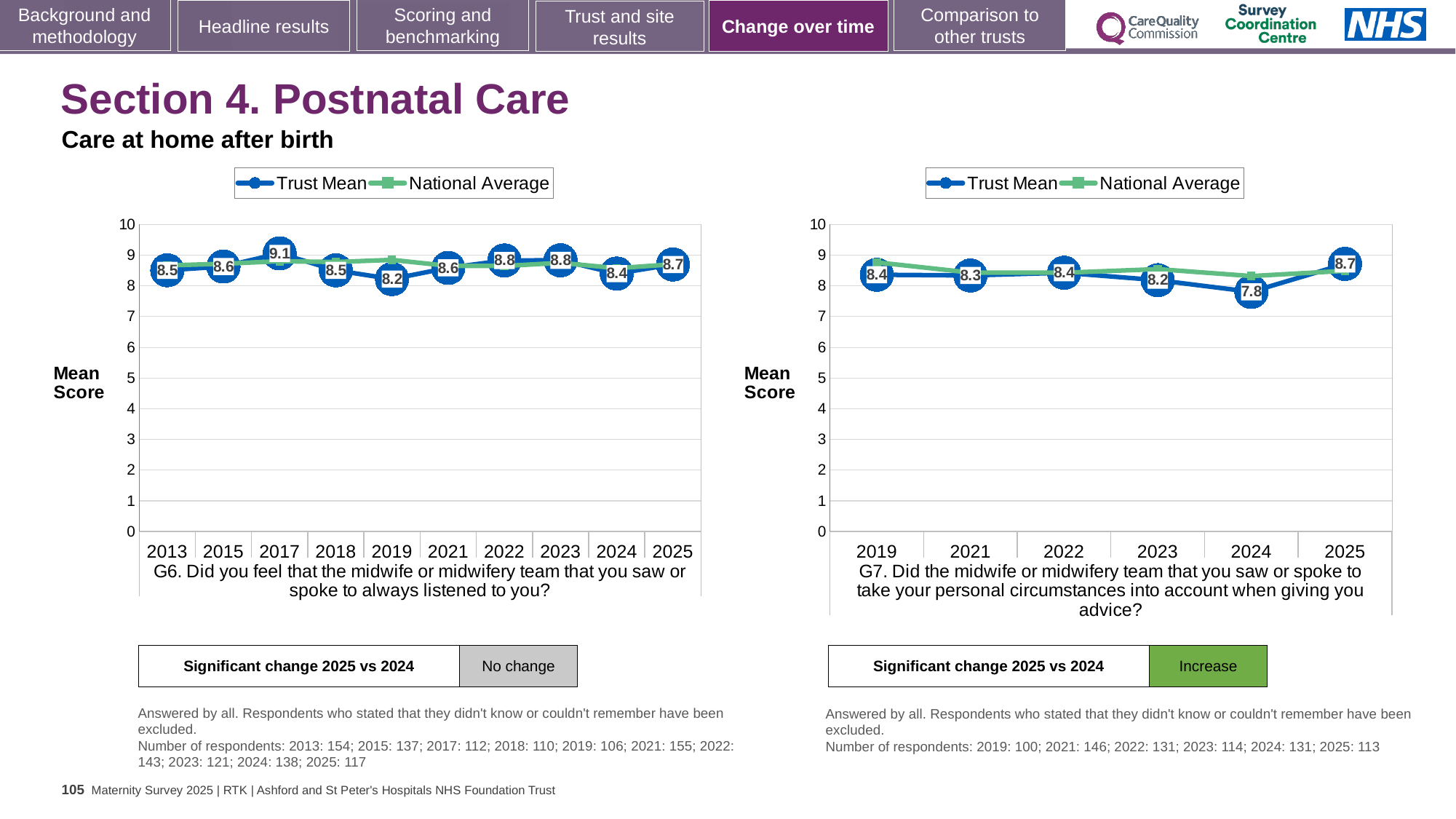
In the right chart (G7), what is the difference between the Trust Mean scores for 2025 and 2024? 0.9 In the right chart (G7), is the Trust Mean score for 2021 larger or smaller than the score for 2024? larger In the left chart (G6), which year has the highest Trust Mean score? 2017 In the right chart (G7), what is the Trust Mean score for 2024? 7.8 In the left chart (G6), what is the Trust Mean score for 2017? 9.1 In the left chart (G6), how many years are shown on the x axis? 10 In the right chart (G7), which year has the highest Trust Mean score? 2025 In the left chart (G6), what is the difference between the Trust Mean scores for 2017 and 2019? 0.9 In the left chart (G6), what is the Trust Mean score for 2019? 8.2 How many series does the legend of the right chart (G7) list? 2 In the right chart (G7), is the National Average value for 2024 greater or less than 7? greater In the left chart (G6), which year has the lowest Trust Mean score? 2019